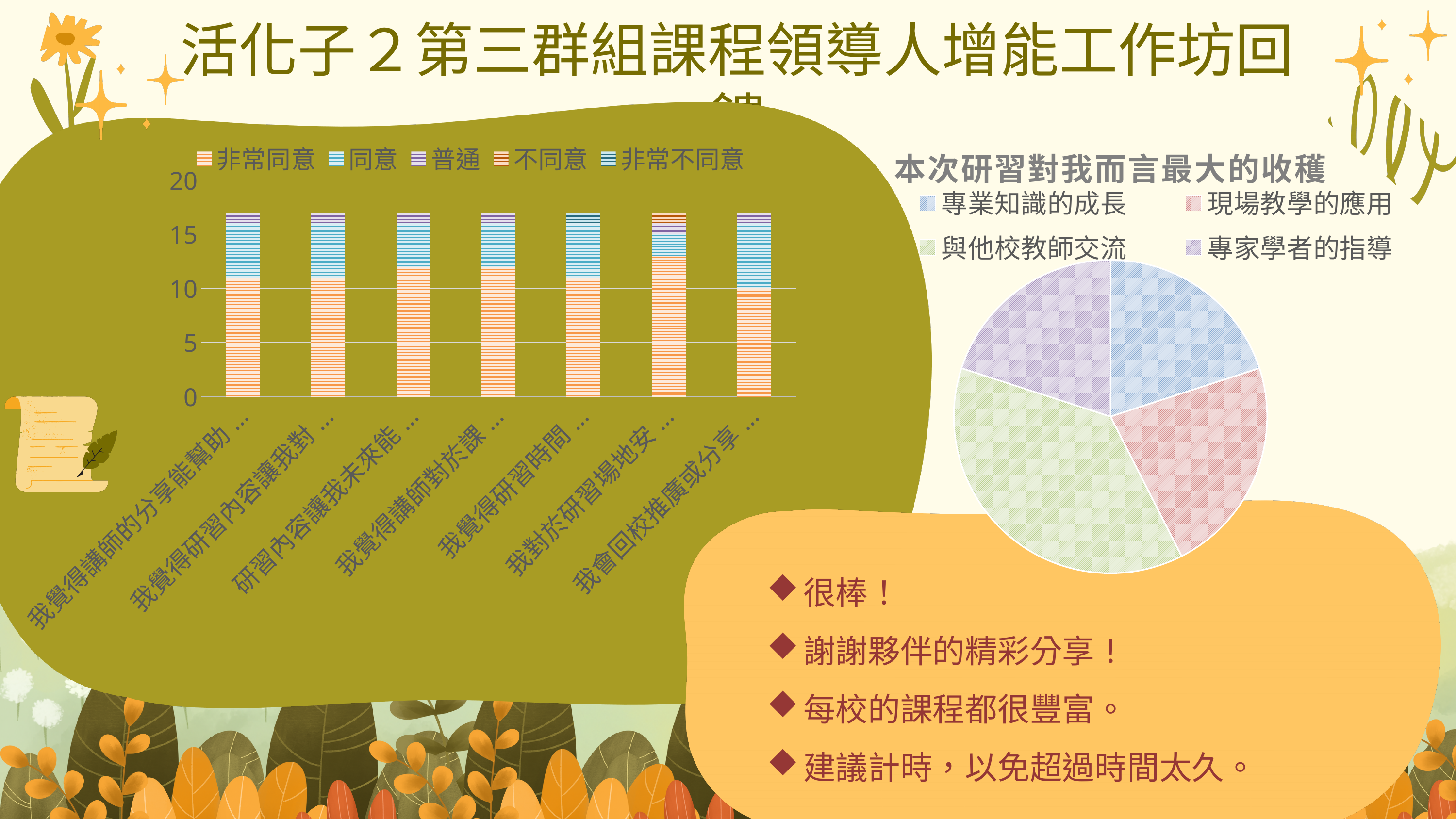
In the left bar chart, is the 非常同意 segment of the first bar (我覺得講師的分享能幫助…) greater or less than 10? greater What kind of chart is the chart on the left side of the slide? bar chart How many slices does the pie chart titled 本次研習對我而言最大的收穫 have? 4 How many bars (categories) are shown in the left bar chart? 7 In the pie chart titled 本次研習對我而言最大的收穫, which slice is larger: 與他校教師交流 or 專業知識的成長? 與他校教師交流 In the left bar chart, is the total height of the first bar (我覺得講師的分享能幫助…) greater or less than 15? greater In the left bar chart, is the total height of the first bar (我覺得講師的分享能幫助…) greater or less than 20? less How many series does the legend of the left bar chart list? 5 What is the title of the pie chart on the right side of the slide? 本次研習對我而言最大的收穫 In the pie chart titled 本次研習對我而言最大的收穫, which slice is larger: 專家學者的指導 or 現場教學的應用? 現場教學的應用 What kind of chart is the chart titled 本次研習對我而言最大的收穫? pie chart